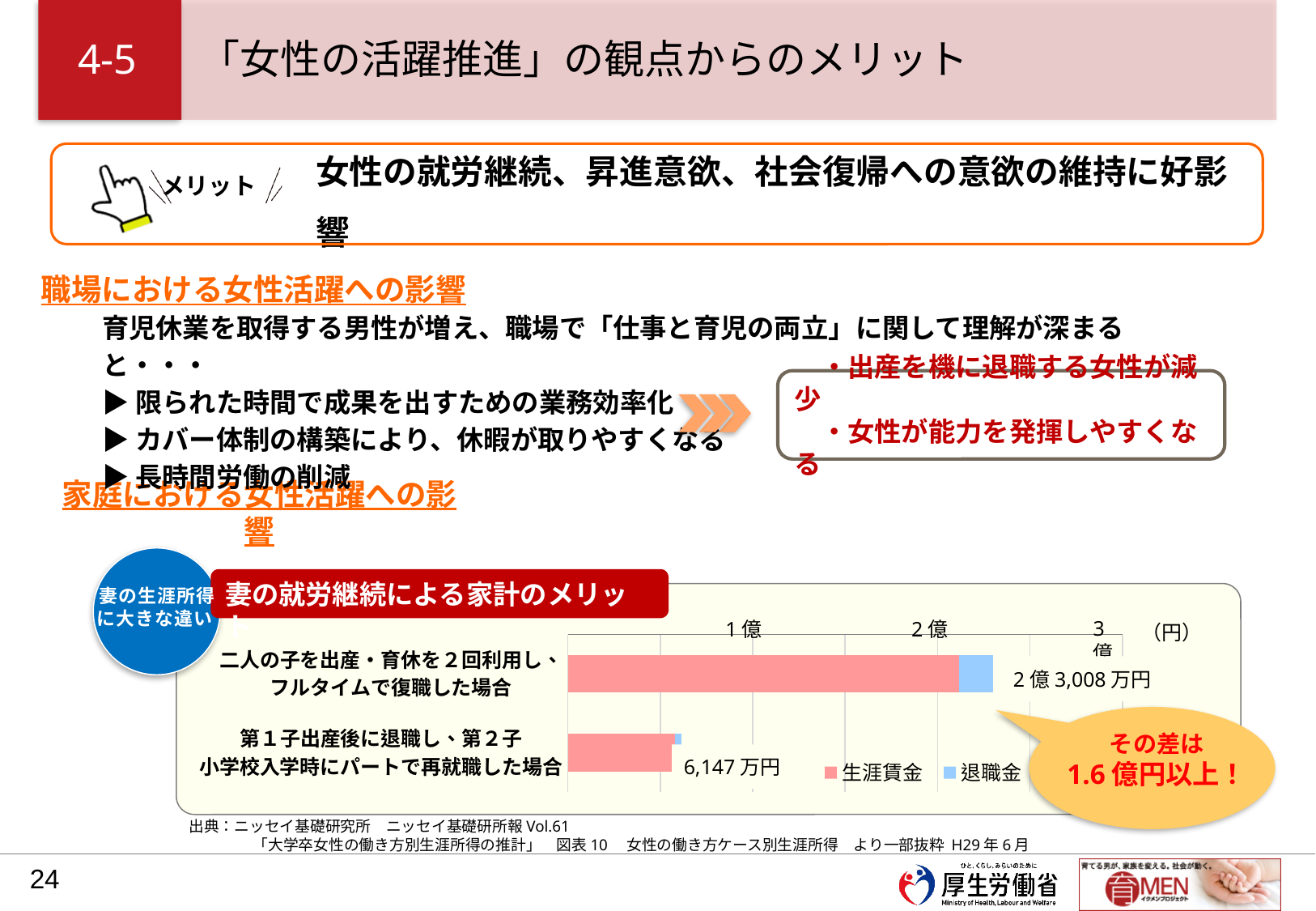
What is the total value labelled for the case 二人の子を出産・育休を2回利用し、フルタイムで復職した場合? 2億3,008万円 Which case has the lower total value in the chart? 第1子出産後に退職し、第2子小学校入学時にパートで再就職した場合 Which case has the higher total value in the chart? 二人の子を出産・育休を2回利用し、フルタイムで復職した場合 What are the two series listed in the chart legend? 生涯賃金, 退職金 Is the total for 第1子出産後に退職し、第2子小学校入学時にパートで再就職した場合 greater or less than 1億? less What kind of chart is shown on the slide? bar chart How many series does the chart legend list? 2 How many categories (cases) are plotted in the chart? 2 What is the difference between the two labelled totals in the chart? 1億6,861万円 Is the total for 二人の子を出産・育休を2回利用し、フルタイムで復職した場合 greater or less than 2億? greater What is the total value labelled for the case 第1子出産後に退職し、第2子小学校入学時にパートで再就職した場合? 6,147万円 What is the title shown above the chart? 妻の就労継続による家計のメリット